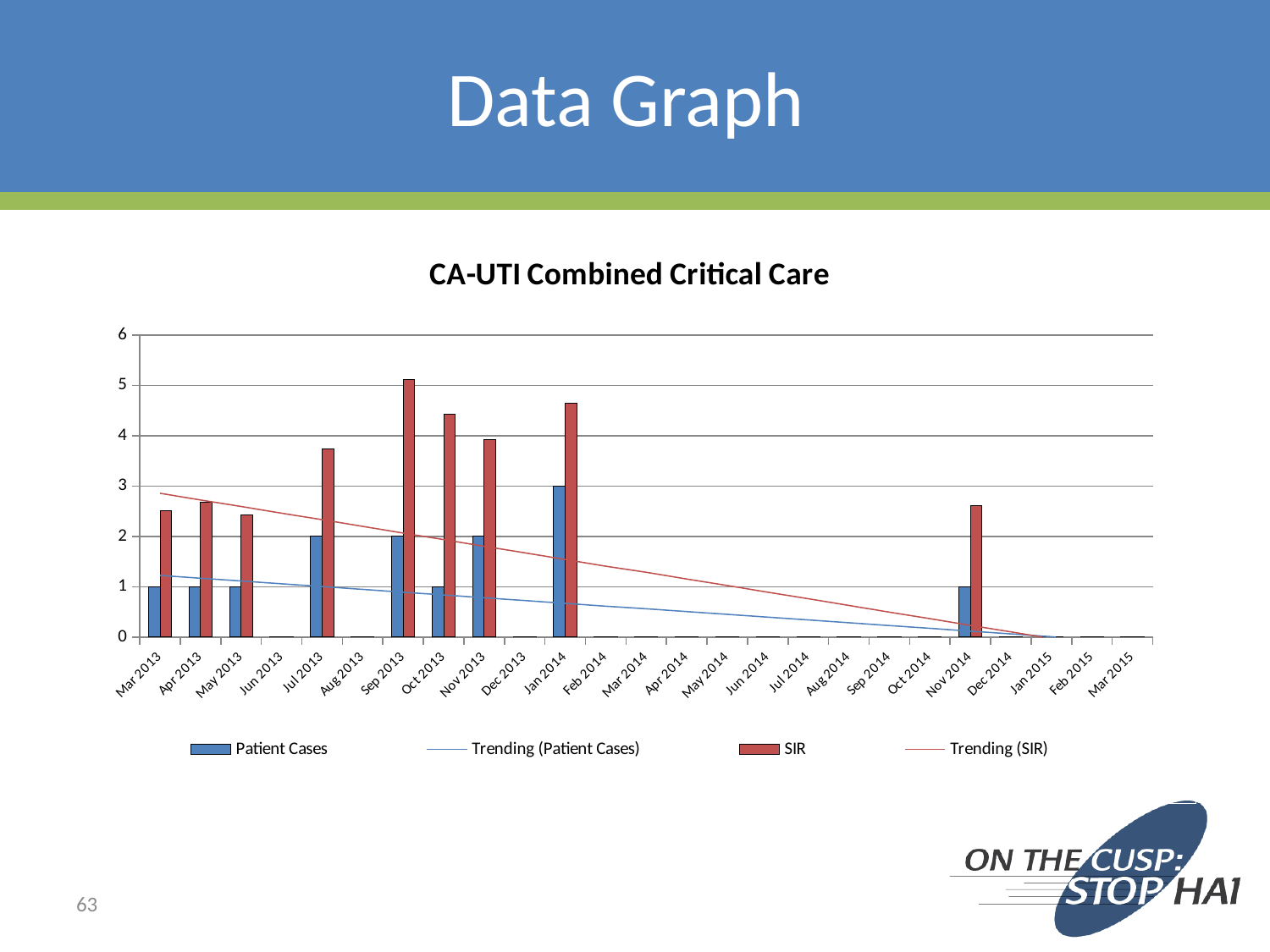
Does the Trending (SIR) line rise or fall from left to right? fall What is the Patient Cases value for Jul 2013? 2 What is the title of the chart? CA-UTI Combined Critical Care How many entries does the legend list? 4 How many months are shown on the x axis? 25 What is the Patient Cases value for Jan 2014? 3 Which month has the highest Patient Cases value? Jan 2014 Is the SIR value for Sep 2013 greater or less than 4? greater Which month has the larger SIR value, Oct 2013 or Nov 2013? Oct 2013 Is the SIR value for Mar 2013 greater or less than 3? less Which month has the highest SIR value? Sep 2013 What kind of chart is shown on the slide? bar chart